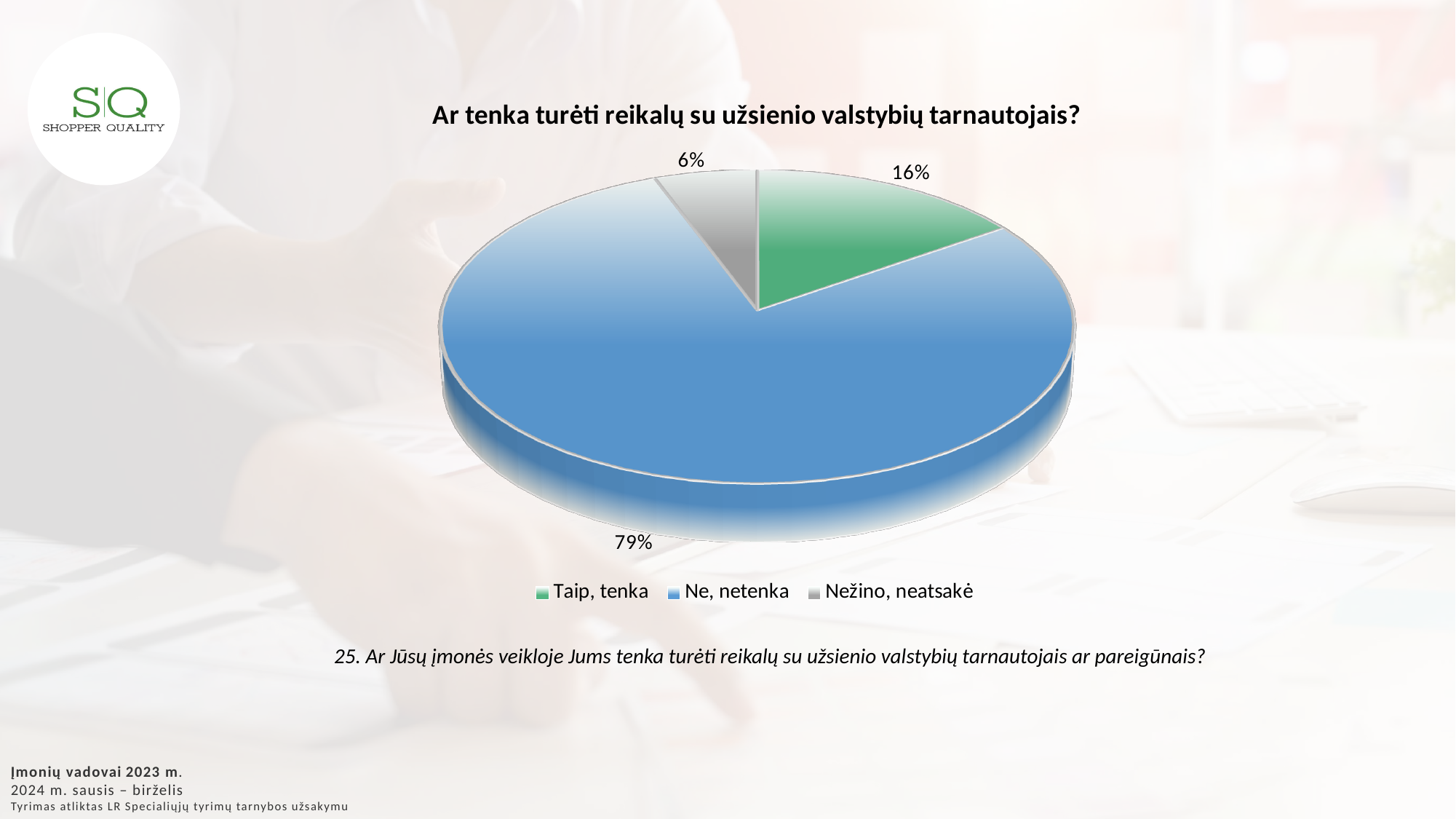
How many slices does the pie chart have? 3 Which is larger, the value for "Taip, tenka" or the value for "Nežino, neatsakė"? Taip, tenka What kind of chart is shown on the slide? Pie chart What is the difference between the values for "Ne, netenka" and "Taip, tenka"? 63% What colour is the slice for "Ne, netenka"? Blue What is the value for "Nežino, neatsakė"? 6% Which category has the smallest share of the pie? Nežino, neatsakė What is the value for "Ne, netenka"? 79% Which category has the largest share of the pie? Ne, netenka What is the value for "Taip, tenka"? 16% What is the title of the chart? Ar tenka turėti reikalų su užsienio valstybių tarnautojais? What is the difference between the values for "Taip, tenka" and "Nežino, neatsakė"? 10%